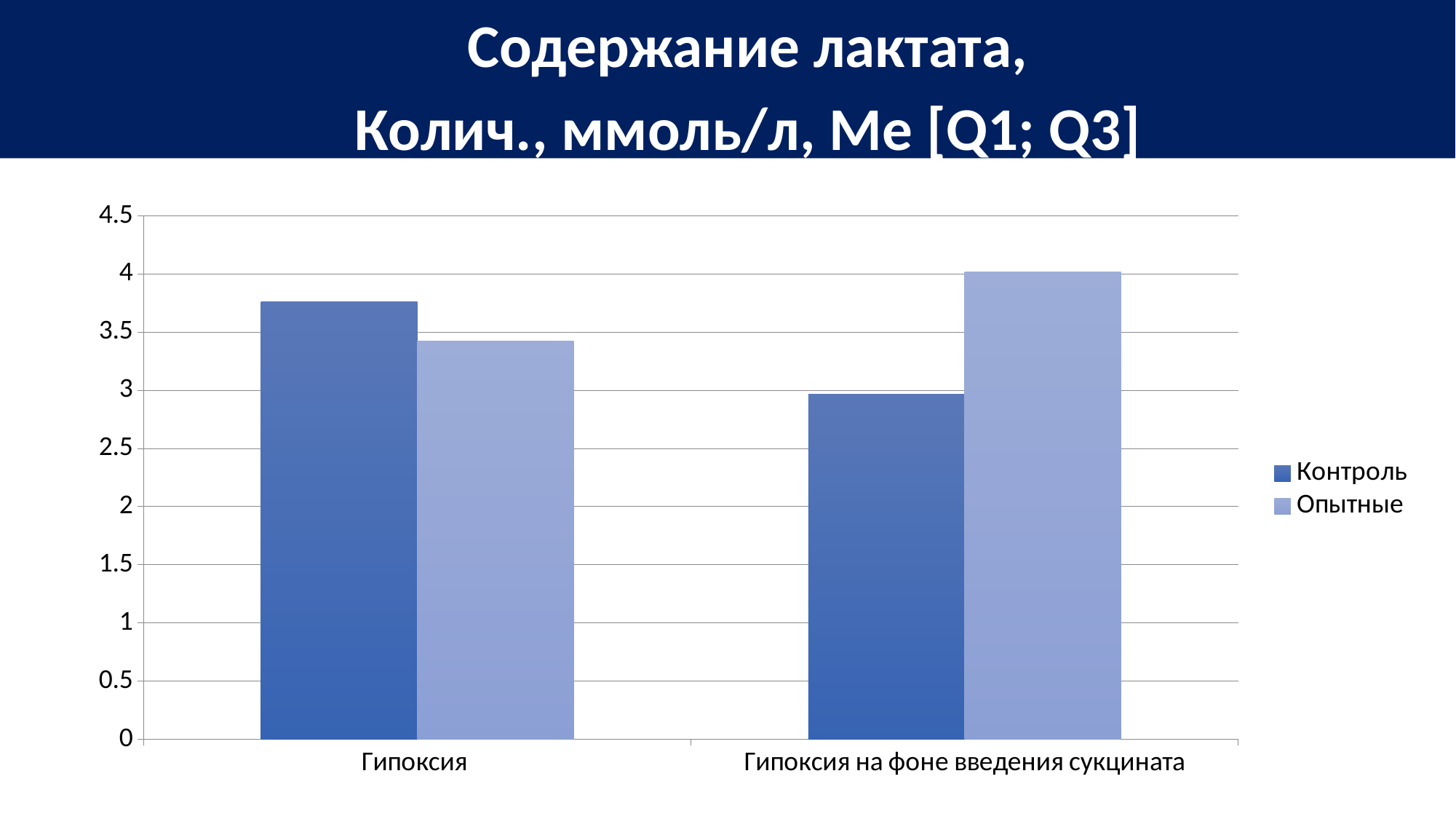
In the Гипоксия category, which series has the larger value, Контроль or Опытные? Контроль Which bar is the tallest in the chart? Опытные in Гипоксия на фоне введения сукцината Is the value for Опытные in the Гипоксия на фоне введения сукцината category greater or less than 3.5? greater What are the two series named in the legend? Контроль and Опытные Is the value for Контроль in the Гипоксия category greater or less than 3.5? greater Is the value for Контроль in the Гипоксия на фоне введения сукцината category greater or less than 3.5? less In the Гипоксия на фоне введения сукцината category, which series has the larger value, Контроль or Опытные? Опытные What kind of chart is shown on the slide? bar chart How many categories are shown on the x axis? 2 How many series does the legend list? 2 What is the title of the chart? Содержание лактата, Колич., ммоль/л, Me [Q1; Q3]